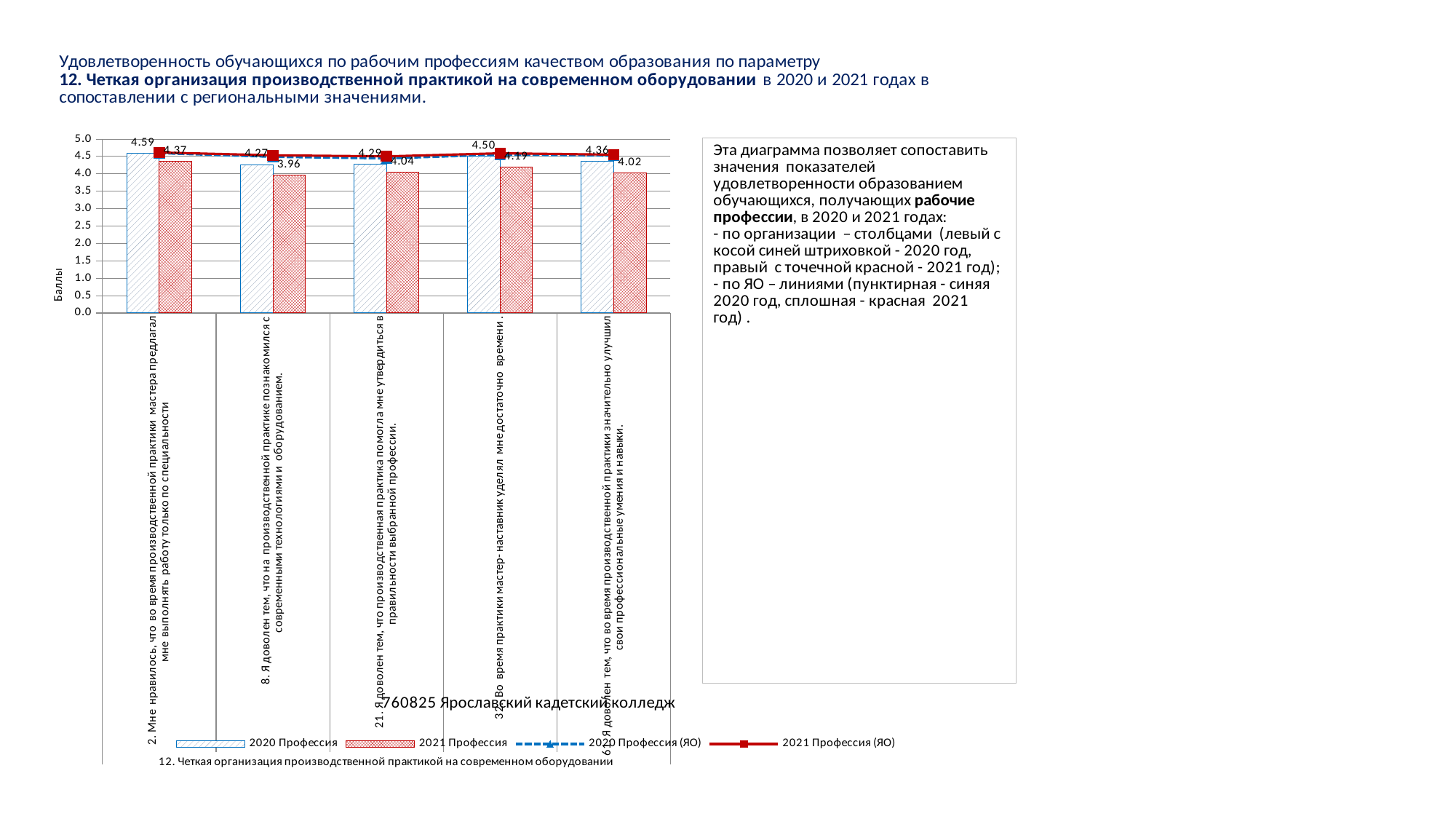
What is the value of the 2020 Профессия bar for statement 2 ("Мне нравилось, что во время производственной практики мастера предлагал мне выполнять работу только по специальности")? 4.59 What is the value of the 2021 Профессия bar for statement 32 ("Во время практики мастер-наставник уделял мне достаточно времени")? 4.19 How many series does the legend list? 4 Which statement has the lowest 2021 Профессия value? 8. Я доволен тем, что на производственной практике познакомился с современными технологиями и оборудованием What is the label of the vertical axis? Баллы Which statement has the highest 2020 Профессия value? 2. Мне нравилось, что во время производственной практики мастера предлагал мне выполнять работу только по специальности How many categories (statements) are plotted along the x axis? 5 For the last (rightmost) statement, which is larger: the 2020 Профессия value or the 2021 Профессия value? 2020 Профессия What is the difference between the 2020 Профессия and 2021 Профессия values for statement 32? 0.31 What type of chart is shown on the slide? bar chart with line series What is the value of the 2020 Профессия bar for statement 21 ("Я доволен тем, что производственная практика помогла мне утвердиться в правильности выбранной профессии")? 4.29 What is the value of the 2021 Профессия bar for statement 8 ("Я доволен тем, что на производственной практике познакомился с современными технологиями и оборудованием")? 3.96